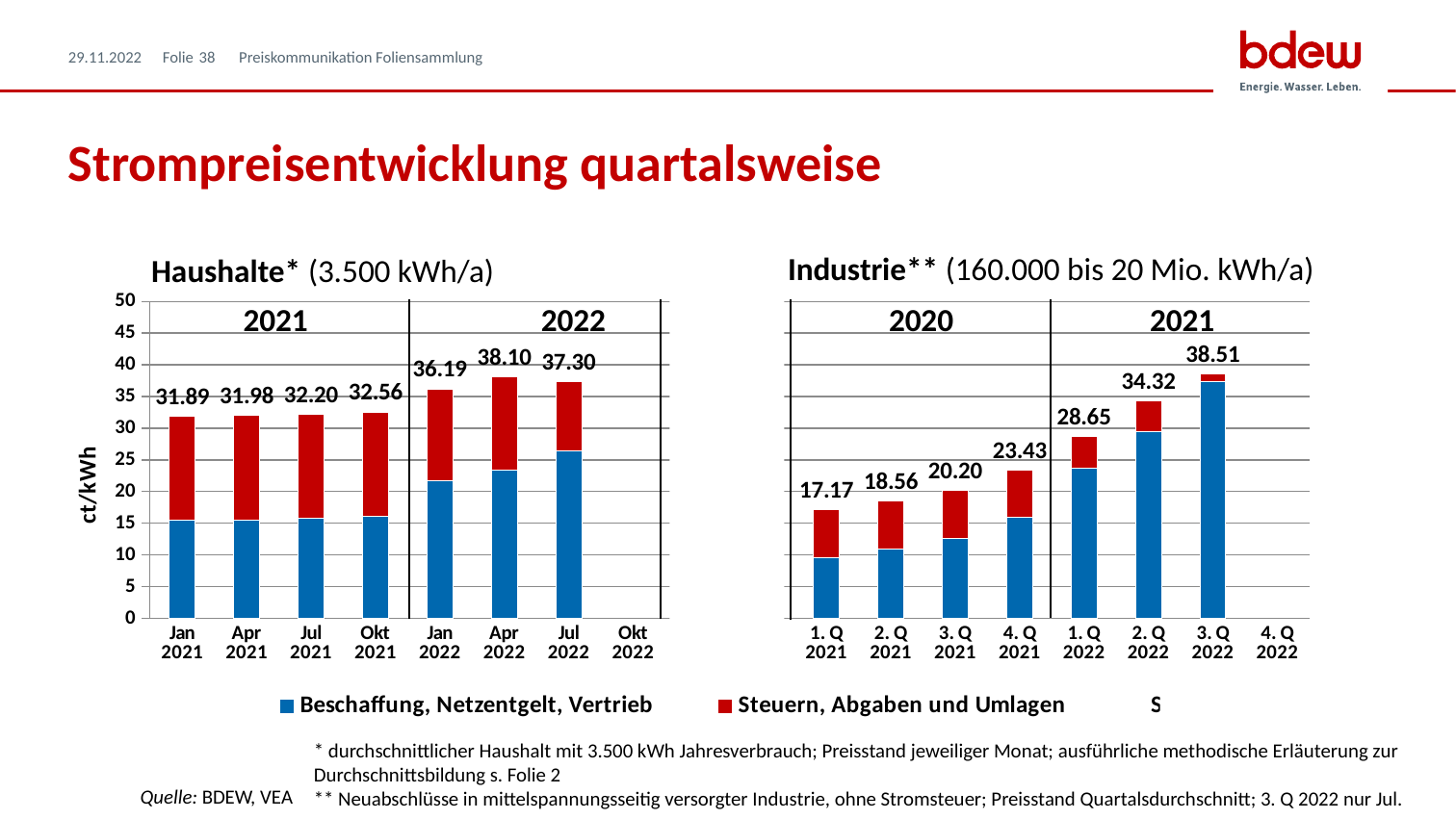
In the Haushalte chart, what is the total value labelled for Apr 2022? 38.10 In the Industrie chart, which quarter has the lowest labelled total? 1. Q 2021 In the Haushalte chart, which is larger: the total for Jul 2022 or the total for Apr 2022? Apr 2022 In the Haushalte chart, how many periods have a bar plotted? 7 How many series does the legend list? 3 What kind of chart is the Industrie chart? Stacked bar chart In the Industrie chart, what is the total value labelled for 2. Q 2022? 34.32 In the Haushalte chart, is the blue Beschaffung, Netzentgelt, Vertrieb segment for Jul 2022 greater or less than 25? greater In the Haushalte chart, what is the difference between the totals for Jan 2022 and Jan 2021? 4.30 In the Industrie chart, do the labelled totals rise or fall from 1. Q 2021 to 3. Q 2022? Rise In the Haushalte chart, which period has the highest labelled total? Apr 2022 In the Industrie chart, what is the difference between the totals for 3. Q 2022 and 1. Q 2022? 9.86